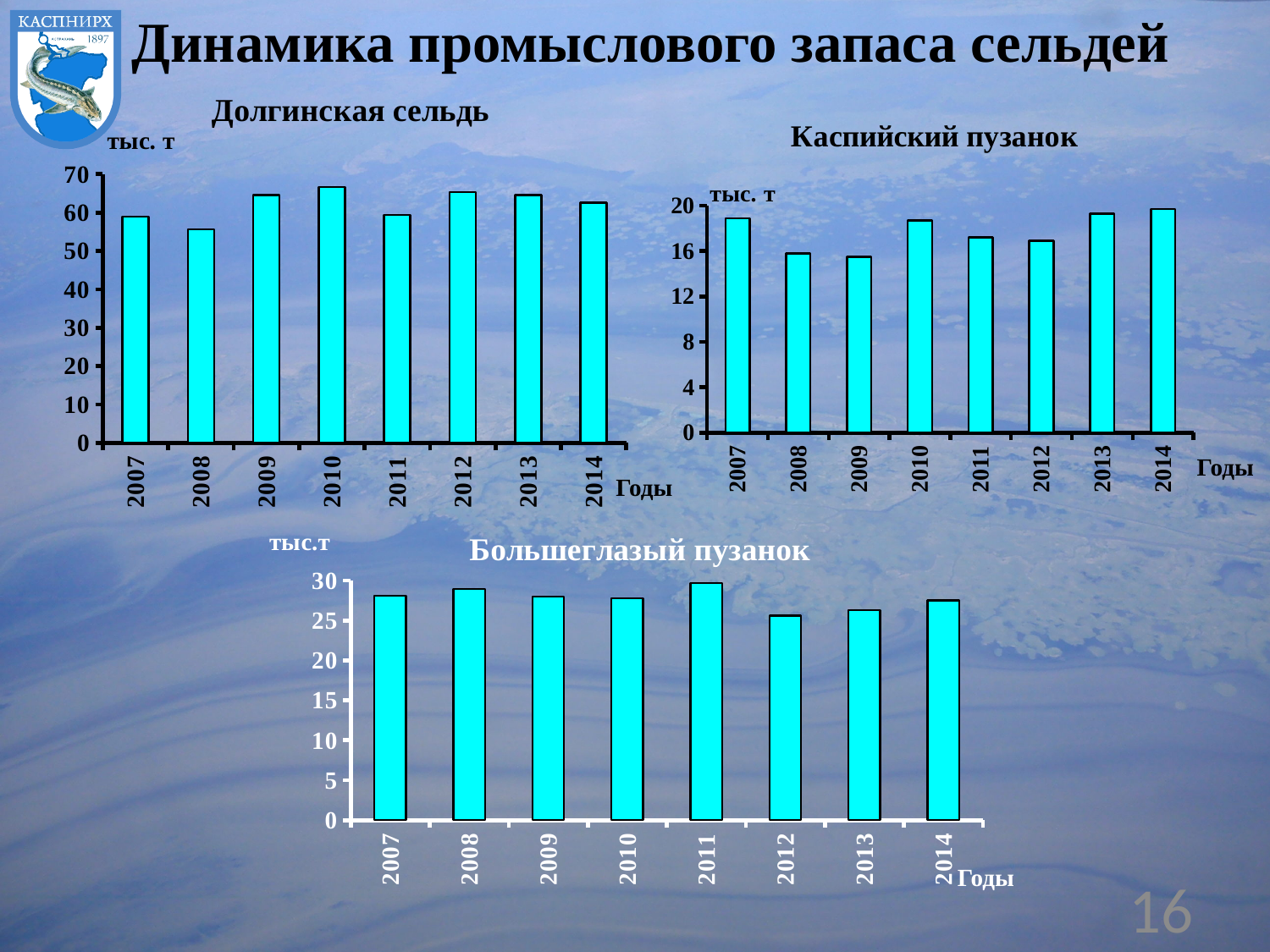
What unit is shown on the y axis of the "Долгинская сельдь" chart? тыс. т In the "Долгинская сельдь" chart, is the value for 2008 greater or less than 60? less What kind of chart is the "Долгинская сельдь" chart? bar chart In the "Каспийский пузанок" chart, which is larger, the value for 2007 or the value for 2008? 2007 How many years are shown on the x axis of the "Каспийский пузанок" chart? 8 In the "Большеглазый пузанок" chart, which is larger, the value for 2008 or the value for 2013? 2008 In the "Долгинская сельдь" chart, which year has the highest value? 2010 In the "Большеглазый пузанок" chart, which year has the lowest value? 2012 In the "Большеглазый пузанок" chart, which year has the highest value? 2011 In the "Долгинская сельдь" chart, which year has the lowest value? 2008